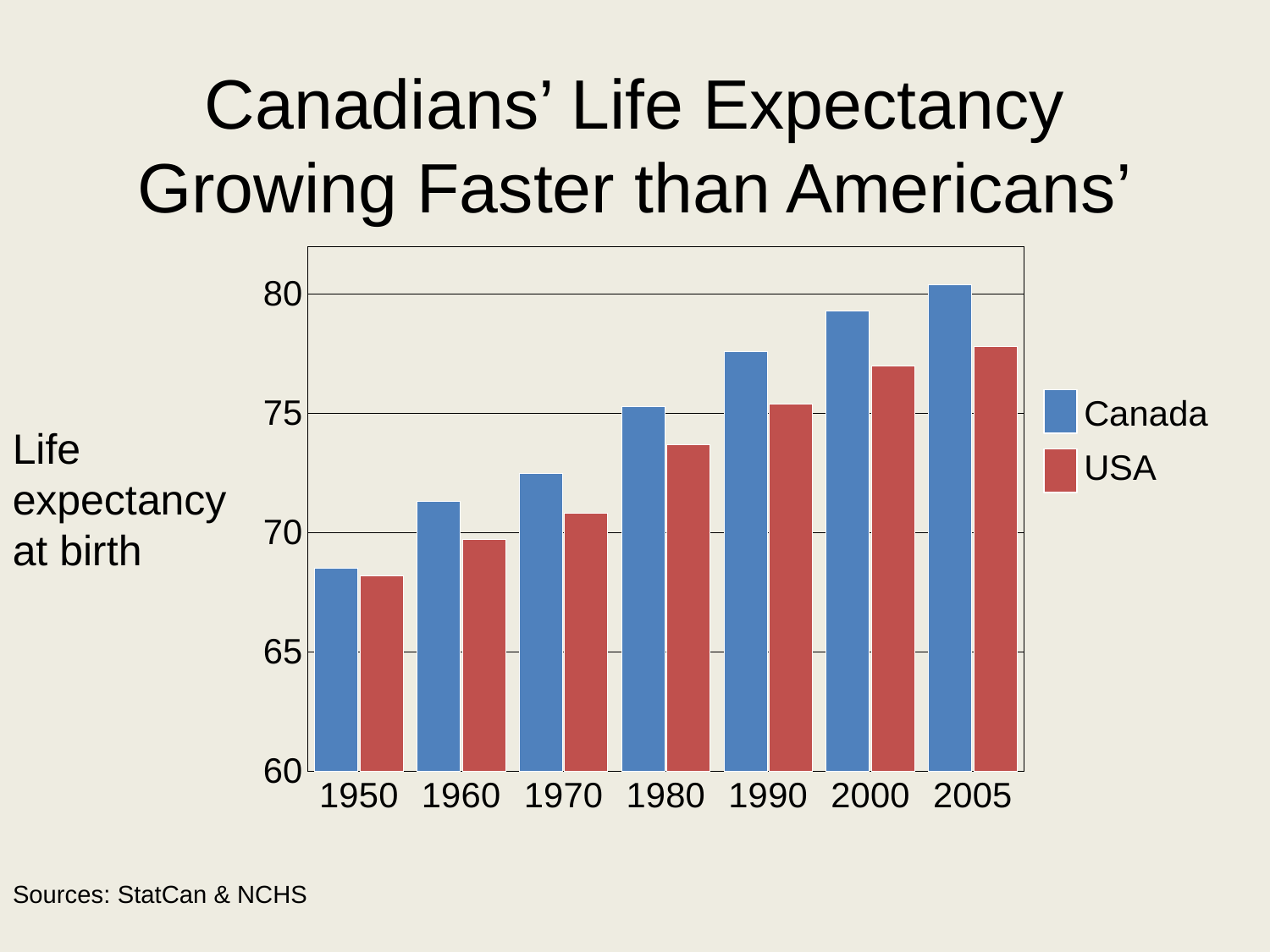
In 2005, which is larger, the value for Canada or the value for the USA? Canada Do the values for Canada rise or fall from 1950 to 2005? rise What is the label on the y axis? Life expectancy at birth How many series does the legend list? 2 In which year is the USA's life expectancy lowest? 1950 How many years are shown on the x axis? 7 What kind of chart is shown on the slide? bar chart Is the value for the USA in 2005 greater or less than 80? less Is the value for the USA in 1960 greater or less than 70? less In which year is Canada's life expectancy highest? 2005 Is the value for Canada in 2005 greater or less than 80? greater Which series is shown in blue? Canada